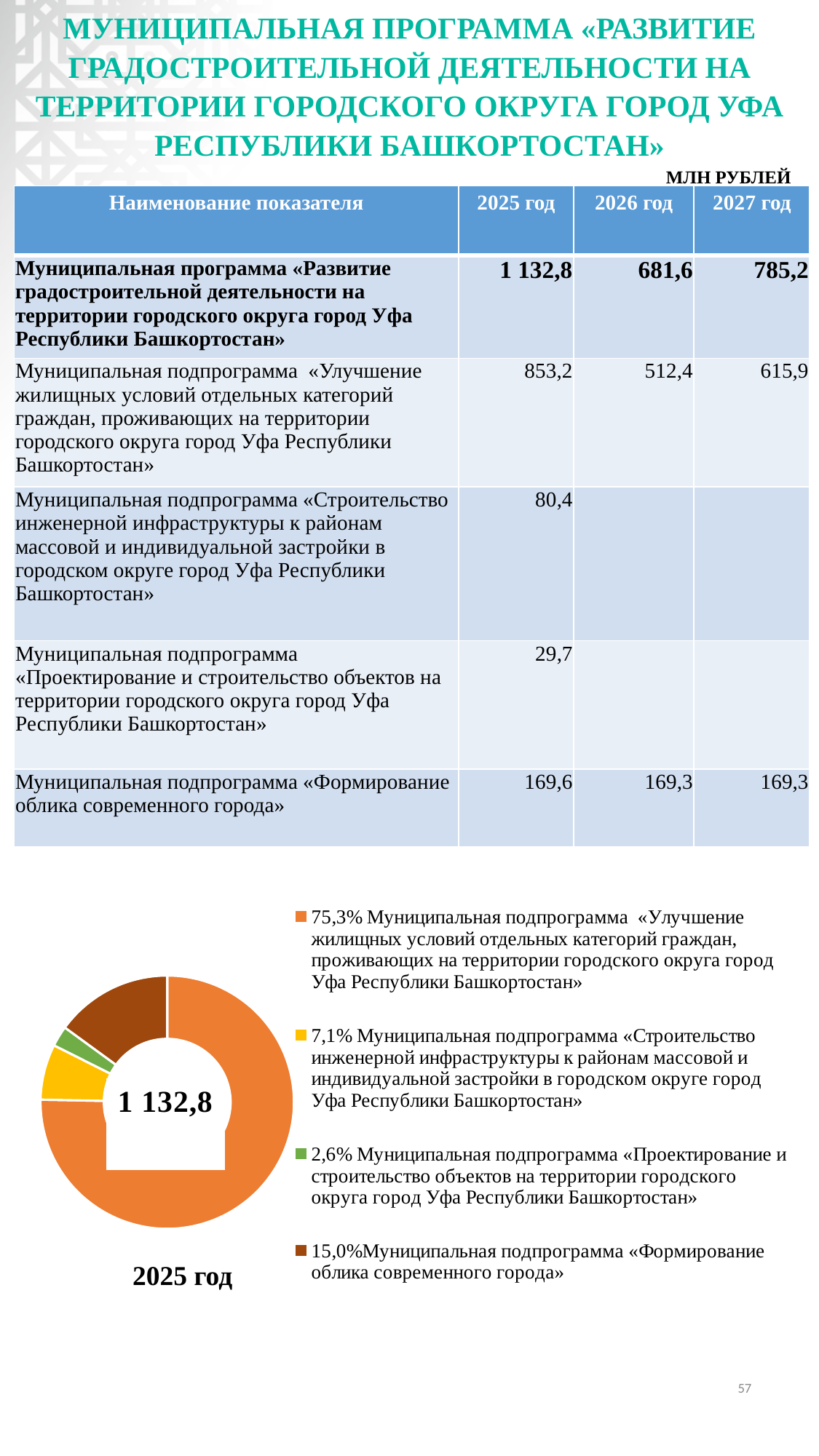
What share of the doughnut chart does the subprogram «Улучшение жилищных условий отдельных категорий граждан...» take? 75,3% How many entries does the legend of the doughnut chart list? 4 What total value is printed in the centre of the doughnut chart? 1 132,8 How many slices does the doughnut chart have? 4 What kind of chart is shown at the bottom of the slide? Doughnut (pie) chart In the doughnut chart, which slice is larger: «Формирование облика современного города» or «Строительство инженерной инфраструктуры...»? «Формирование облика современного города» Which subprogram has the smallest slice in the doughnut chart? Муниципальная подпрограмма «Проектирование и строительство объектов на территории городского округа город Уфа Республики Башкортостан» What share of the doughnut chart does the subprogram «Строительство инженерной инфраструктуры к районам массовой и индивидуальной застройки...» take? 7,1% What share of the doughnut chart does the subprogram «Проектирование и строительство объектов на территории городского округа город Уфа...» take? 2,6% Which subprogram has the largest slice in the doughnut chart? Муниципальная подпрограмма «Улучшение жилищных условий отдельных категорий граждан, проживающих на территории городского округа город Уфа Республики Башкортостан» Which year does the doughnut chart represent, according to the label beneath it? 2025 год